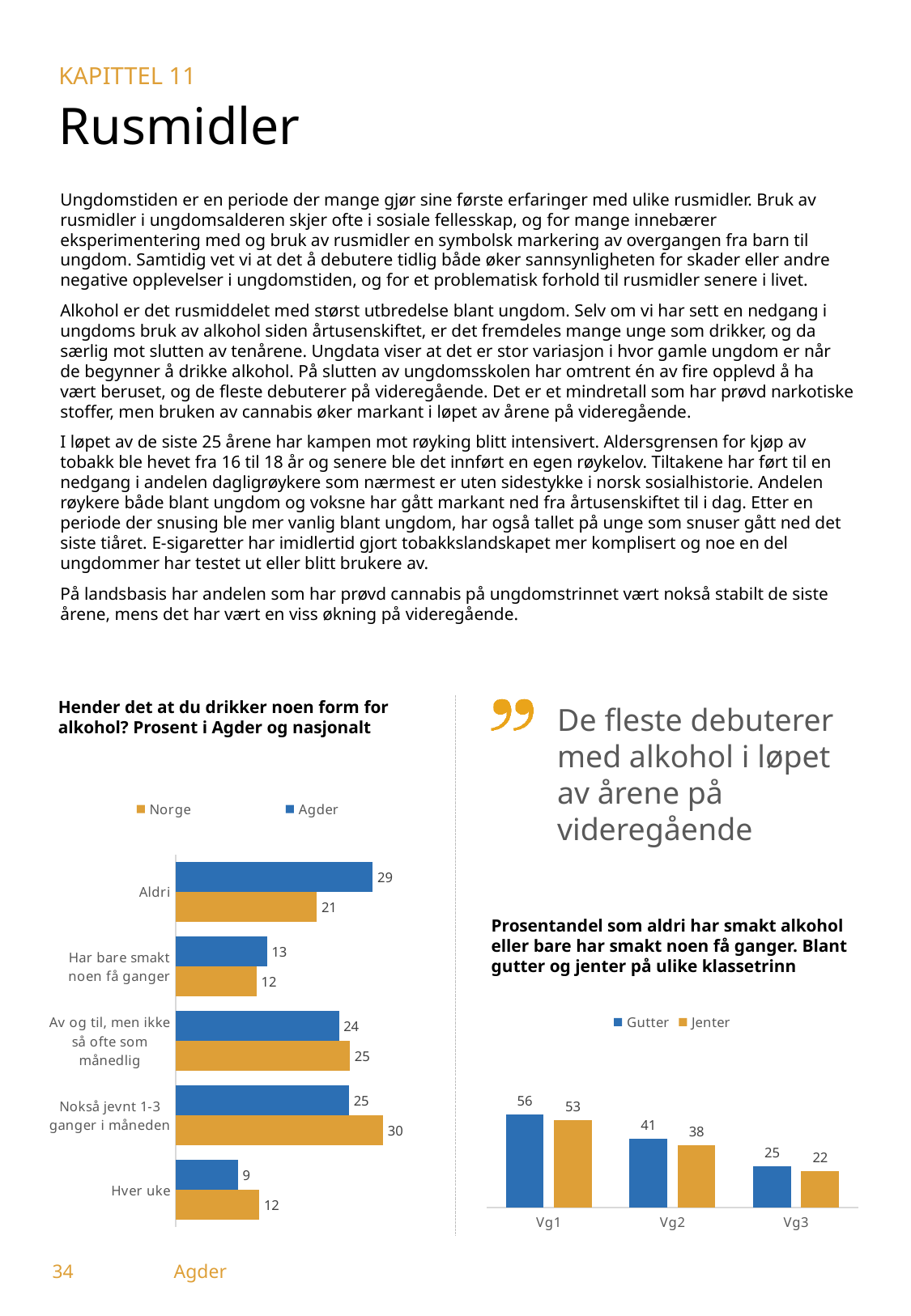
In the chart 'Hender det at du drikker noen form for alkohol?', which category has the lowest value for Agder? Hver uke In the chart 'Hender det at du drikker noen form for alkohol?', what is the value for Agder in the category 'Aldri'? 29 In the chart 'Prosentandel som aldri har smakt alkohol eller bare har smakt noen få ganger', how many series does the legend list? 2 In the chart 'Hender det at du drikker noen form for alkohol?', which category has the highest value for Norge? Nokså jevnt 1-3 ganger i måneden In the chart 'Prosentandel som aldri har smakt alkohol eller bare har smakt noen få ganger', what is the value for Jenter at Vg2? 38 In the chart 'Hender det at du drikker noen form for alkohol?', what is the value for Norge in the category 'Hver uke'? 12 In the chart 'Prosentandel som aldri har smakt alkohol eller bare har smakt noen få ganger', which class level has the highest value for Gutter? Vg1 In the chart 'Hender det at du drikker noen form for alkohol?', what kind of chart is it? Bar chart In the chart 'Prosentandel som aldri har smakt alkohol eller bare har smakt noen få ganger', what is the difference between Gutter and Jenter at Vg3? 3 In the chart 'Hender det at du drikker noen form for alkohol?', how many categories are shown? 5 In the chart 'Hender det at du drikker noen form for alkohol?', what is the difference between Agder and Norge for 'Aldri'? 8 In the chart 'Prosentandel som aldri har smakt alkohol eller bare har smakt noen få ganger', do the values for Gutter rise or fall from Vg1 to Vg3? Fall